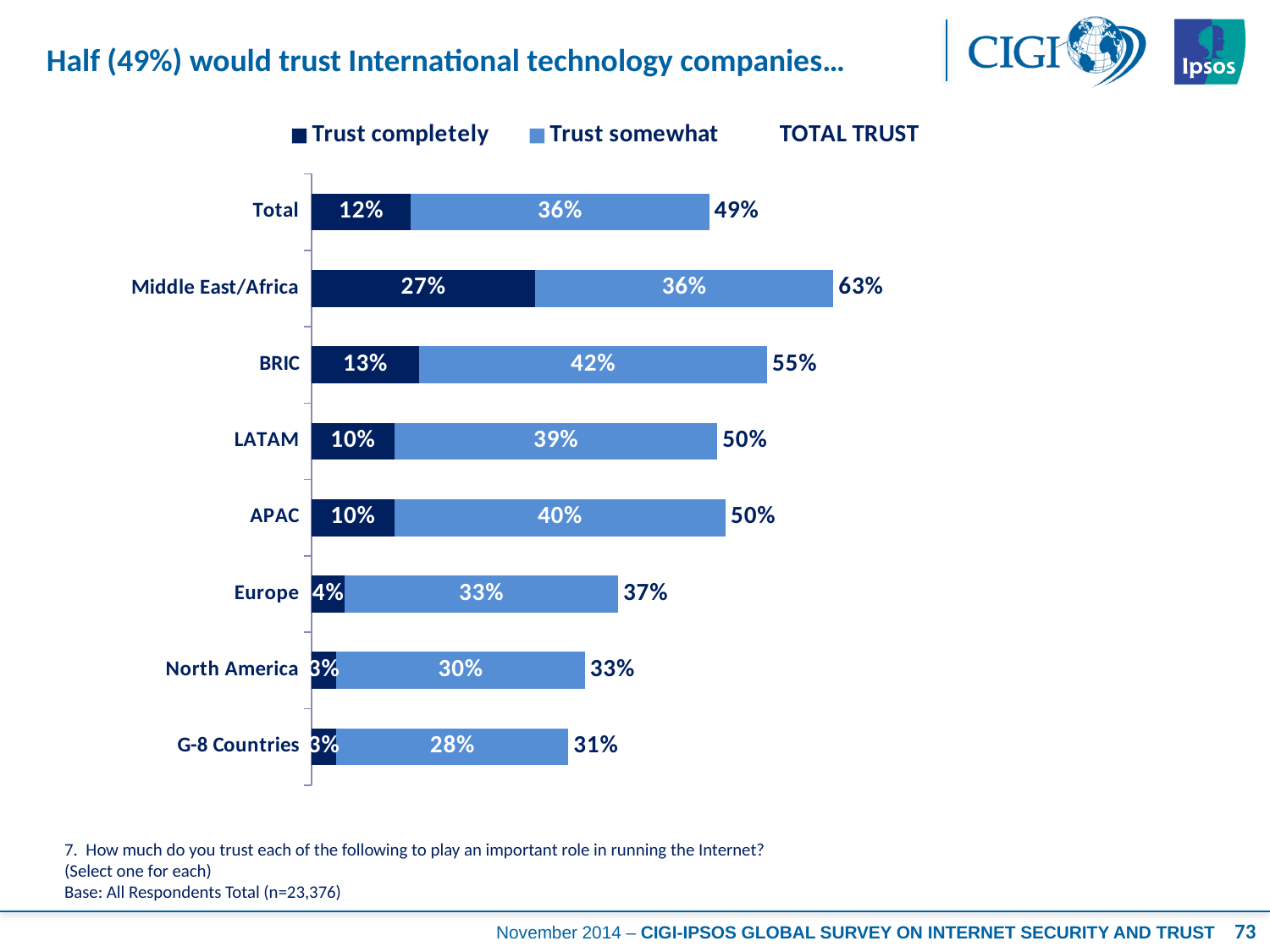
What percentage of respondents in Middle East/Africa say they 'Trust completely' international technology companies? 27% Which category has the lowest TOTAL TRUST value? G-8 Countries Which colour represents 'Trust completely' in the chart? Dark navy blue Which region has the highest TOTAL TRUST value? Middle East/Africa How many categories (bars) are shown in the chart? 8 What TOTAL TRUST value is shown for Europe? 37% What is the 'Trust somewhat' value for BRIC? 42% What type of chart is shown on the slide? Stacked bar chart Which has a larger 'Trust somewhat' value, LATAM or North America? LATAM What is the difference between the 'Trust somewhat' values for BRIC and Europe? 9 percentage points How many series does the legend list as stacked bar segments? 2 How many percentage points higher is the 'Trust completely' value for Middle East/Africa than for Total? 15 percentage points